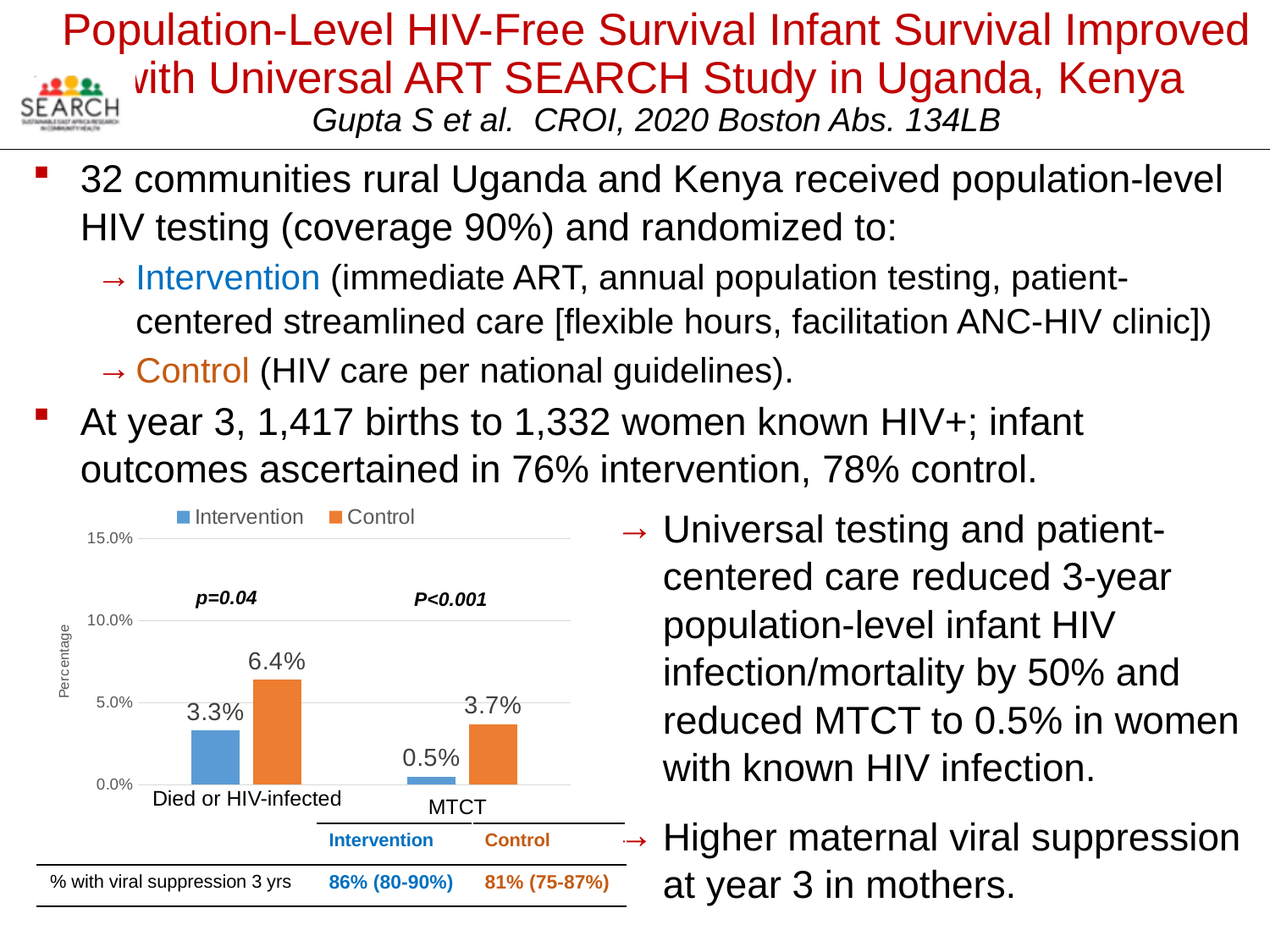
How many series does the chart legend list? 2 Which bar in the chart has the highest value? Control, Died or HIV-infected For MTCT, which is larger: the Intervention value or the Control value? Control Which bar in the chart has the lowest value? Intervention, MTCT What is the Control value for MTCT? 3.7% What is the Control value for the 'Died or HIV-infected' category? 6.4% What is the Intervention value for MTCT? 0.5% What is the difference between the Control and Intervention values for 'Died or HIV-infected'? 3.1% What type of chart is shown on the slide? Bar chart What is the label of the y-axis of the chart? Percentage What is the difference between the Control and Intervention values for MTCT? 3.2% What is the Intervention value for the 'Died or HIV-infected' category? 3.3%